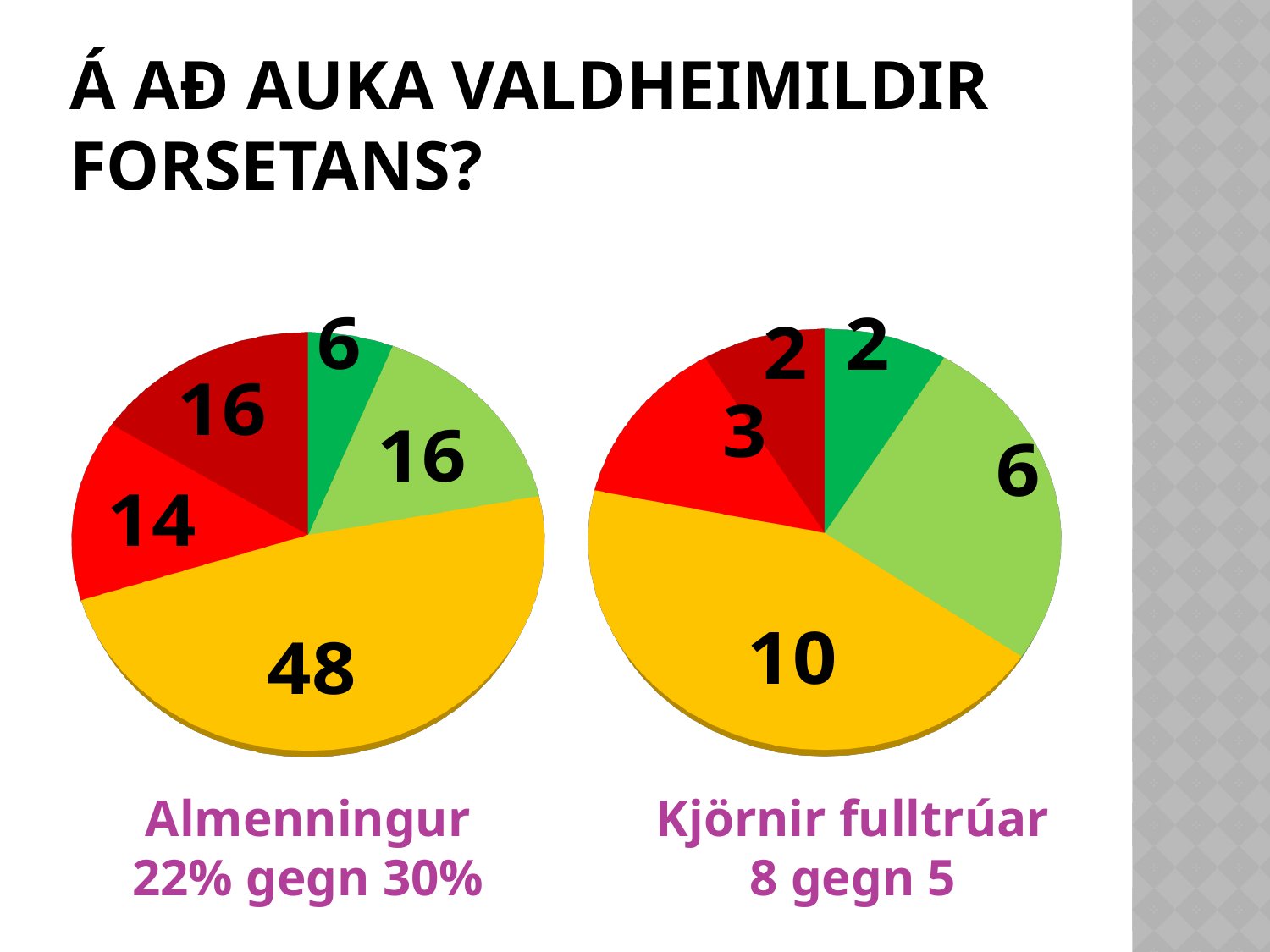
In the Almenningur pie chart, which is larger: the yellow slice or the bright red slice? the yellow slice In the Almenningur pie chart, what is the difference between the yellow slice (48) and the bright red slice (14)? 34 How many slices does the Almenningur pie chart have? 5 In the Kjörnir fulltrúar pie chart, what is the difference between the yellow slice (10) and the light green slice (6)? 4 In the Kjörnir fulltrúar pie chart, what is the smallest value shown on any slice? 2 What kind of chart is shown on the left of the slide? pie chart How many slices does the Kjörnir fulltrúar pie chart have? 5 In the Almenningur pie chart, what is the value of the largest slice? 48 What is the sum of all slice values in the Kjörnir fulltrúar pie chart? 23 In the Kjörnir fulltrúar pie chart, what is the value of the light green slice? 6 In the Almenningur pie chart, what is the value of the yellow slice? 48 In the Kjörnir fulltrúar pie chart, what is the value of the largest slice? 10